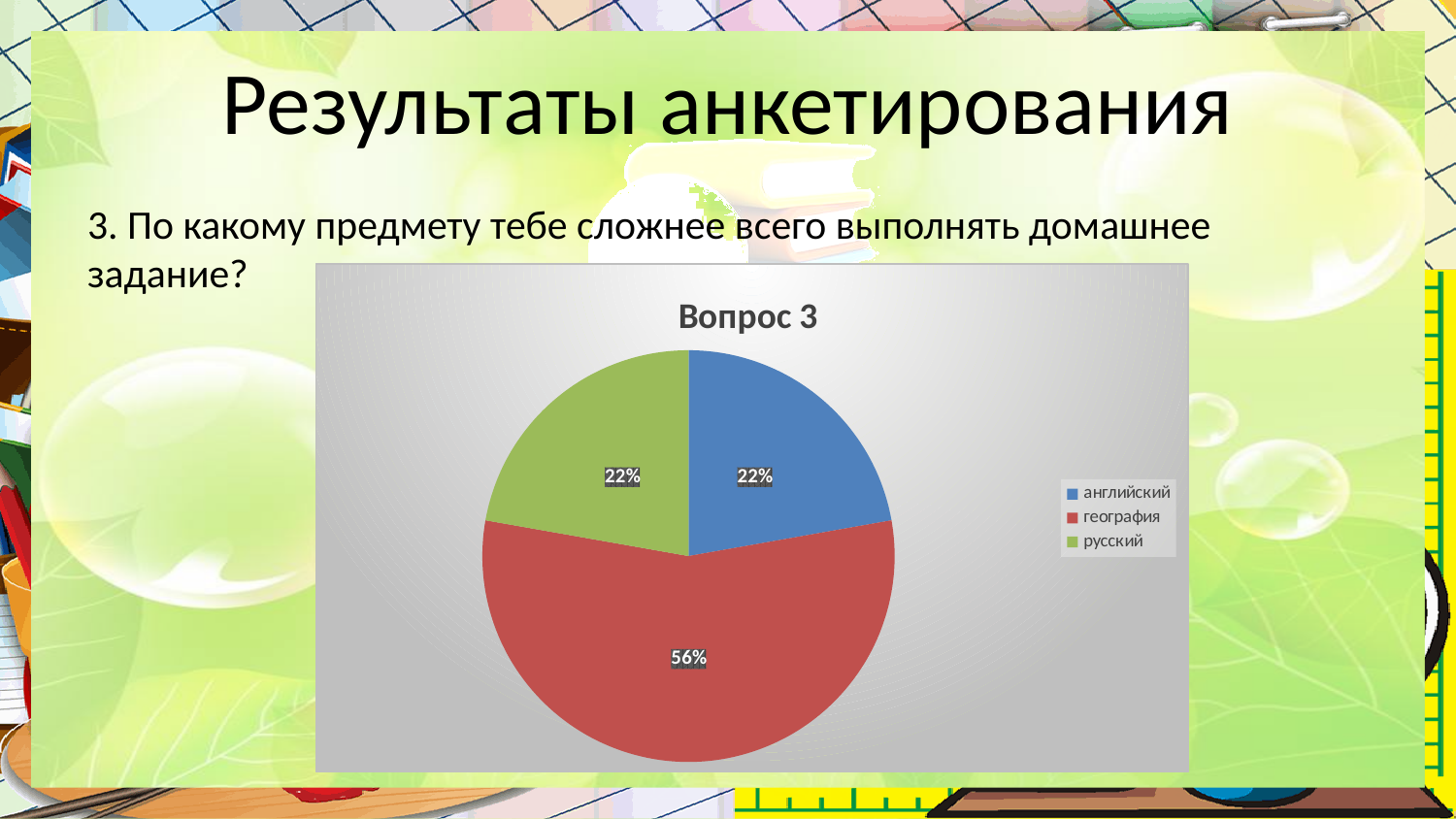
Is the share for география greater or less than 50%? greater What is the title of the chart? Вопрос 3 Which colour represents география in the chart? red Which category has the largest slice of the pie? география What is the difference between the shares of география and английский? 34% What kind of chart is shown on the slide? pie chart How many entries does the legend list? 3 What share of the pie does география have? 56% What share of the pie does русский have? 22% How many slices does the pie chart have? 3 Which is larger, the share for география or the share for русский? география What share of the pie does английский have? 22%